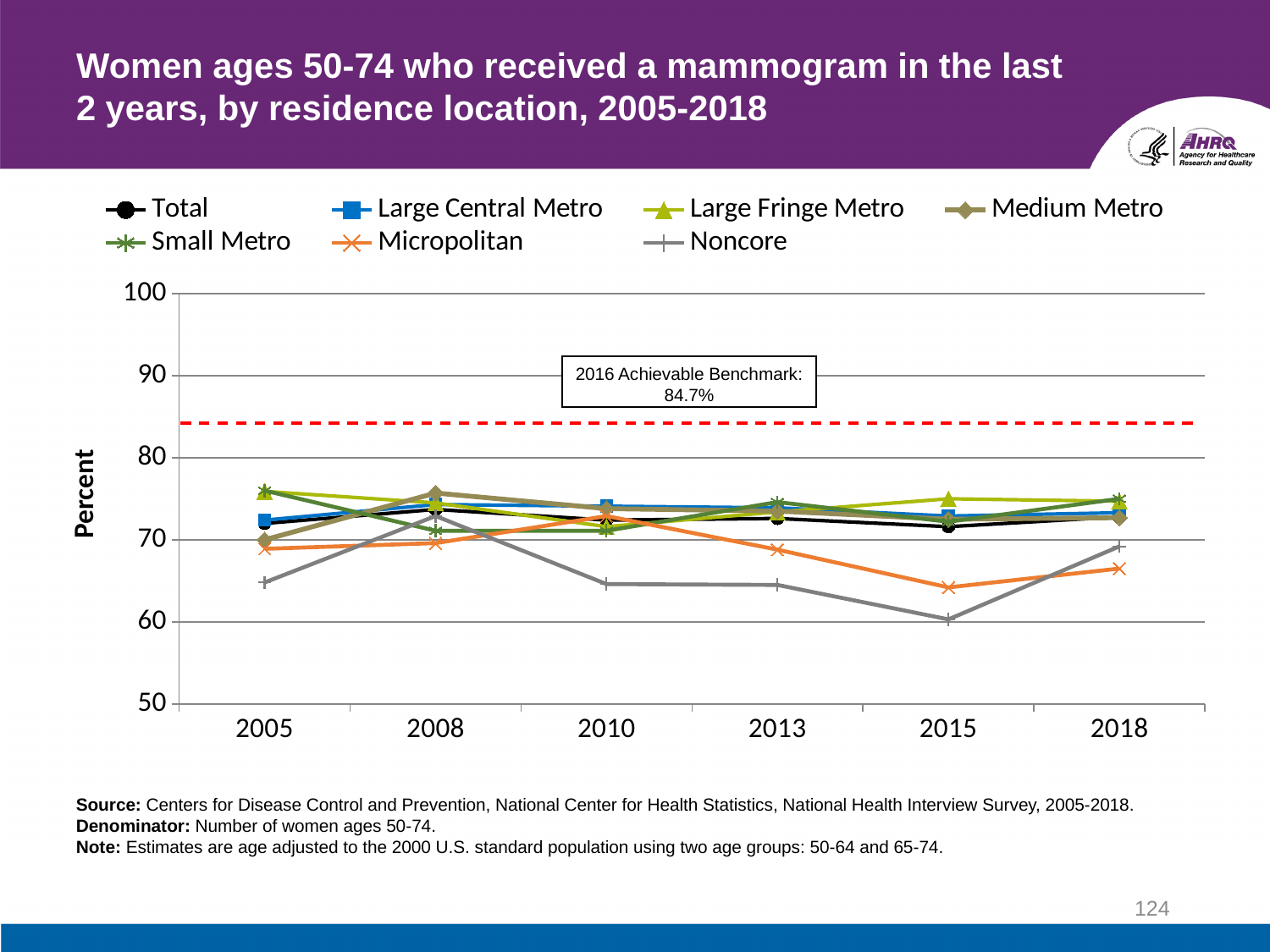
What kind of chart is shown on the slide? Line chart Does the Noncore series rise or fall from 2008 to 2015? Fall Which series has the lowest value in 2015? Noncore How many series does the legend list? 7 Is the value for Noncore in 2015 greater or less than 70? less What is the label on the y axis? Percent In 2013, which is larger: the value for Micropolitan or the value for Noncore? Micropolitan How many years are plotted along the x axis? 6 Which series has the lowest value in 2005? Noncore Is the value for Total in 2008 greater or less than 80? less What is the 2016 Achievable Benchmark value shown on the chart? 84.7% Is the value for Large Fringe Metro in 2015 greater or less than 70? greater